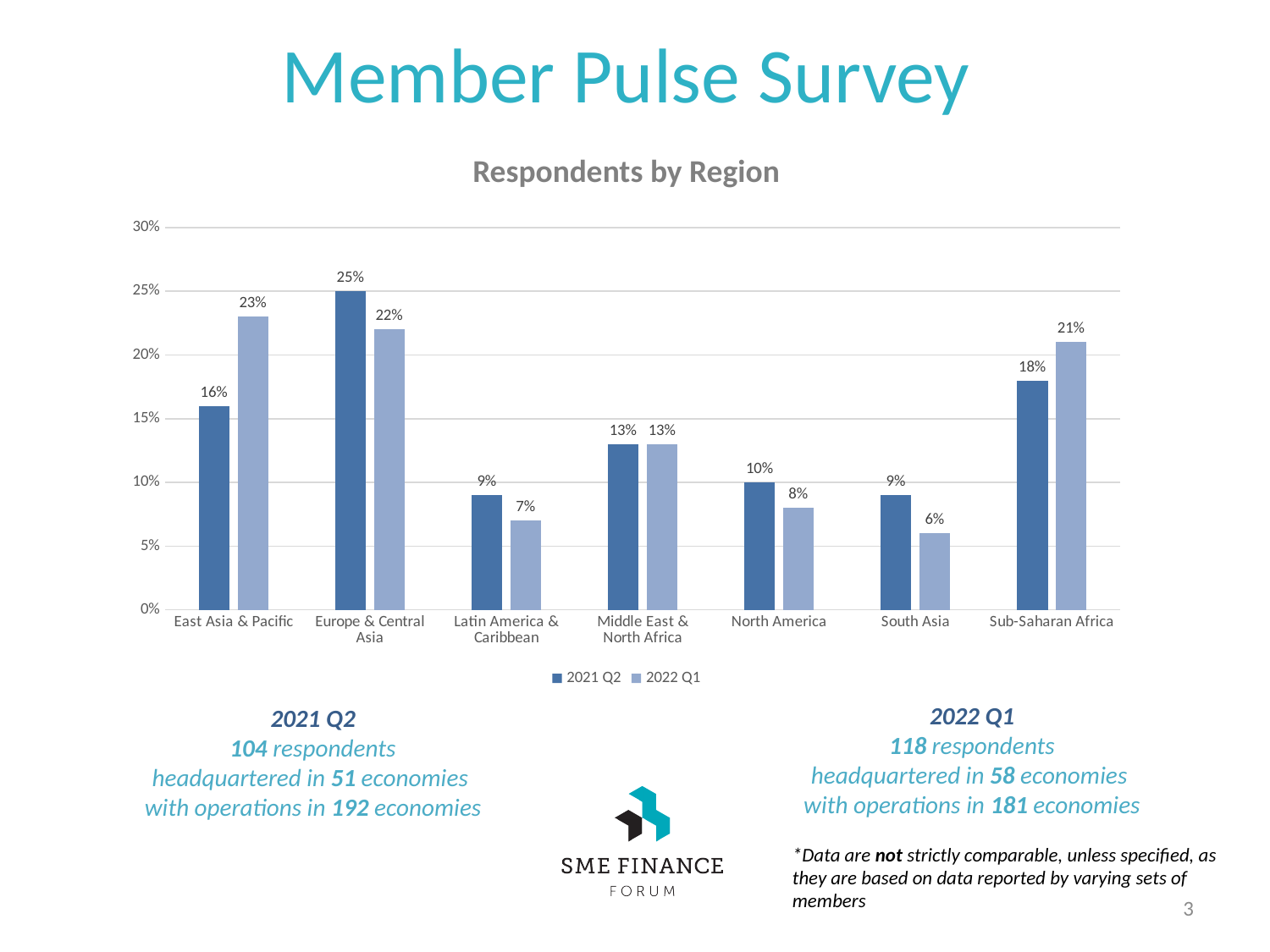
Is the 2021 Q2 value for Europe & Central Asia greater or less than 20%? greater How many series does the legend list? 2 Which region has the highest 2021 Q2 value? Europe & Central Asia What is the 2022 Q1 value for Sub-Saharan Africa? 21% Which region has the lowest 2022 Q1 value? South Asia Which is larger for North America: the 2021 Q2 value or the 2022 Q1 value? 2021 Q2 What is the difference between the 2022 Q1 and 2021 Q2 values for East Asia & Pacific? 7% What kind of chart is shown? bar chart What is the 2021 Q2 value for East Asia & Pacific? 16% How many regions are shown on the x axis? 7 What is the 2022 Q1 value for South Asia? 6% What is the title of the chart? Respondents by Region